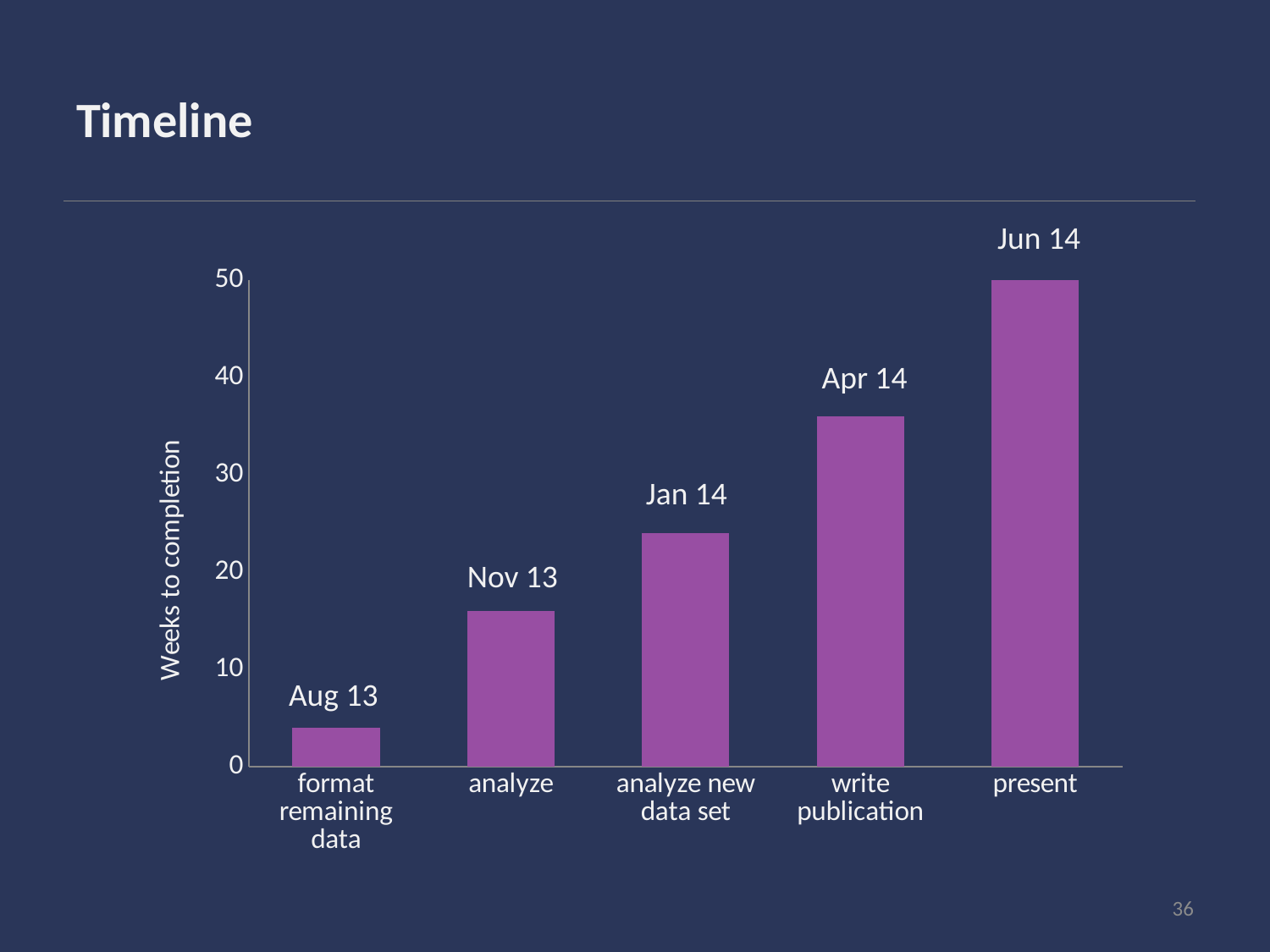
What is the label on the y axis of the chart? Weeks to completion Which category has the lowest number of weeks to completion? format remaining data Is the value for 'analyze' greater or less than 20? less What date label is shown above the 'present' bar? Jun 14 Which has more weeks to completion, 'analyze' or 'write publication'? write publication What kind of chart is shown on the slide? bar chart Is the value for 'analyze new data set' greater or less than 20? greater Is the value for 'write publication' greater or less than 30? greater How many categories are shown on the x axis of the chart? 5 Which category has the highest number of weeks to completion? present Do the bar values rise or fall from left to right along the x axis? rise